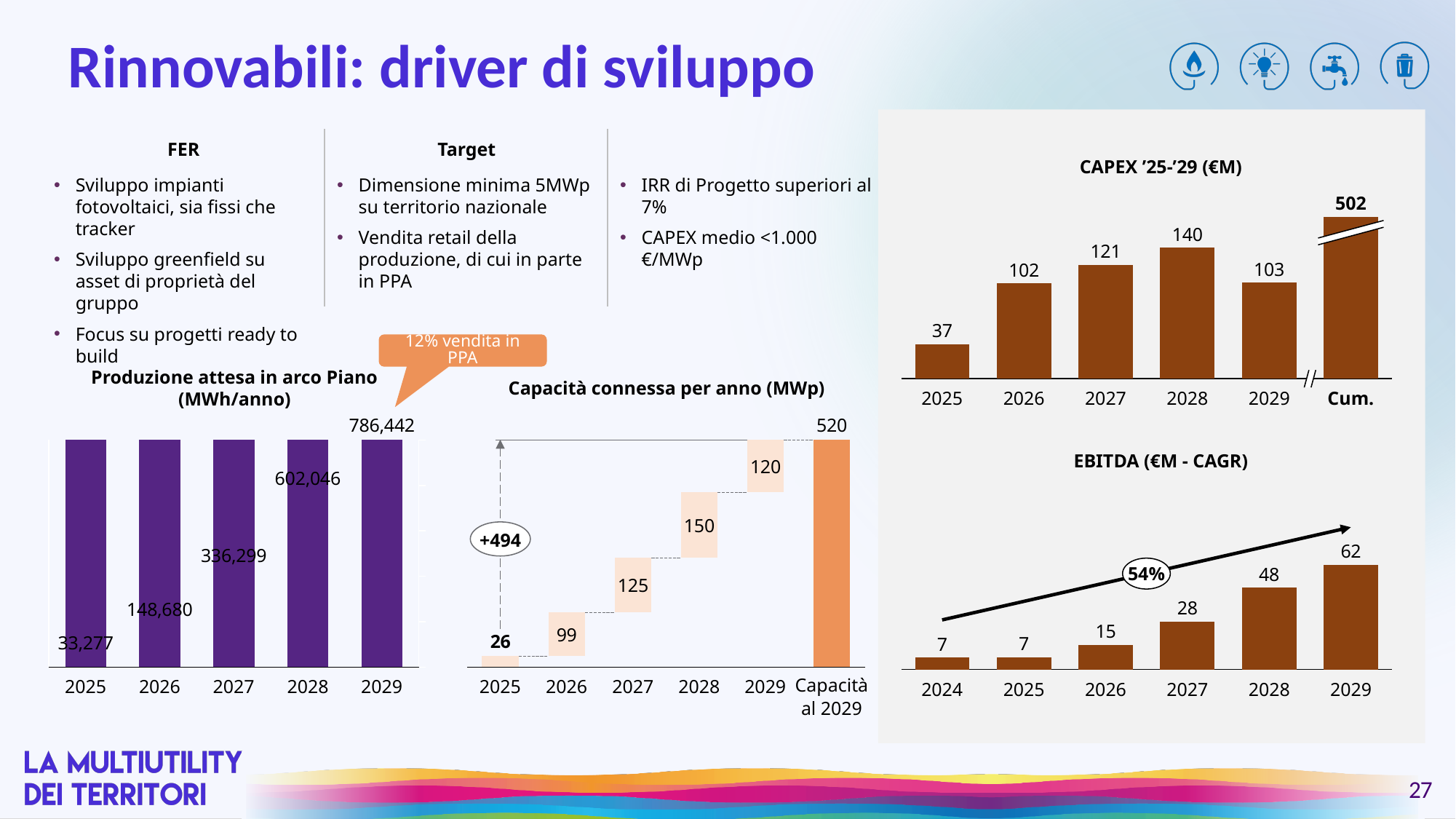
In the EBITDA (€M - CAGR) chart, what CAGR percentage is shown on the arrow? 54% In the EBITDA (€M - CAGR) chart, which year has the highest value? 2029 In the Capacità connessa per anno (MWp) chart, what is the value for 2028? 150 In the EBITDA (€M - CAGR) chart, what is the value for 2029? 62 In the CAPEX '25-'29 (€M) chart, what is the value for 2028? 140 In the EBITDA (€M - CAGR) chart, do the values rise or fall from 2024 to 2029? rise In the EBITDA (€M - CAGR) chart, how many years are shown on the x axis? 6 In the Capacità connessa per anno (MWp) chart, what is the total capacity at 2029 (Capacità al 2029)? 520 In the CAPEX '25-'29 (€M) chart, which year has the lowest value? 2025 In the CAPEX '25-'29 (€M) chart, what is the difference between the 2028 and 2029 values? 37 In the CAPEX '25-'29 (€M) chart, what is the cumulative (Cum.) value? 502 In the Produzione attesa in arco Piano (MWh/anno) chart, what is the value for 2027? 336,299